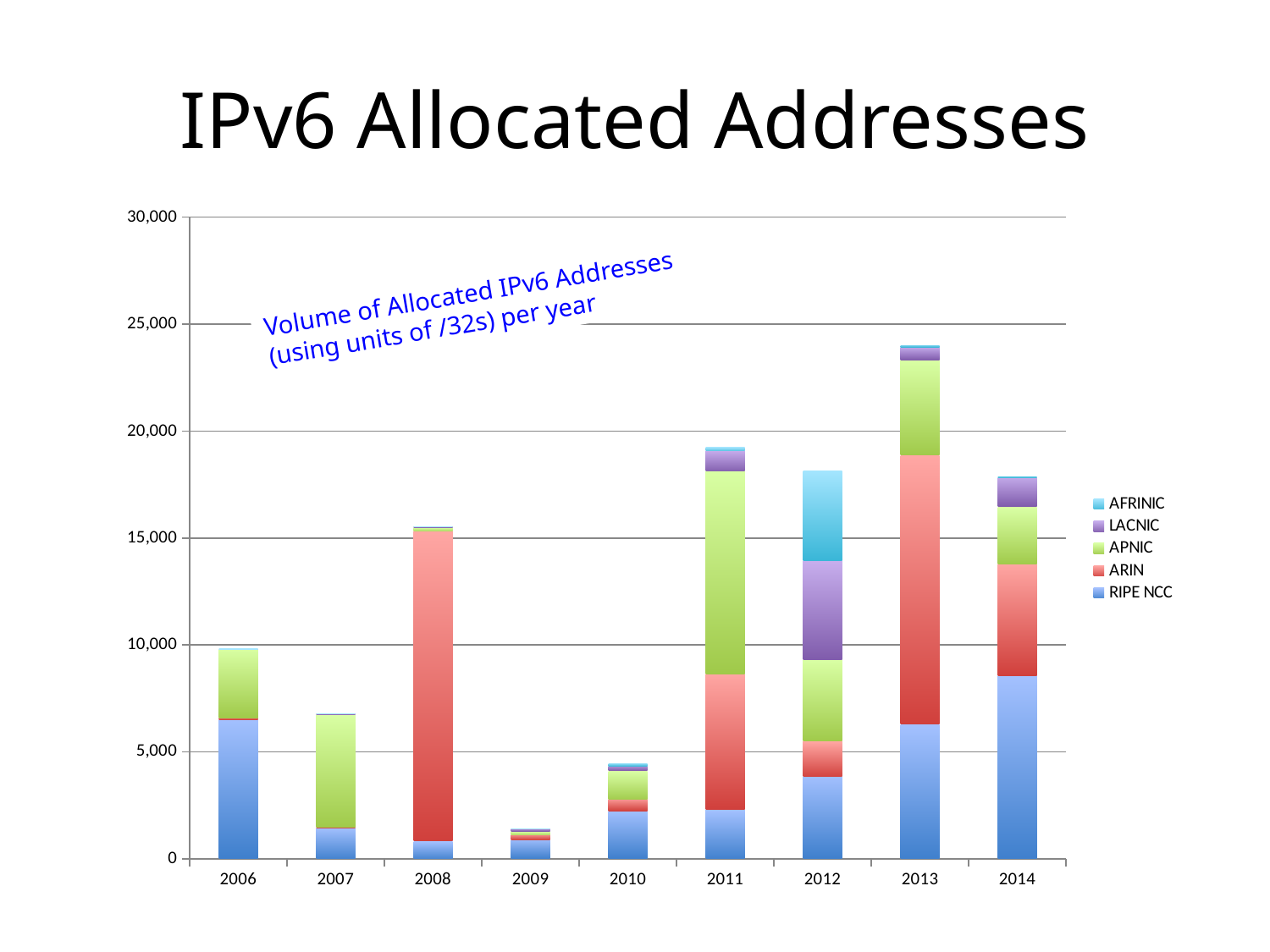
Is the total for 2009 greater or less than 5,000? less Is the total for 2010 greater or less than 5,000? less Which year has the lowest total volume of allocated IPv6 addresses? 2009 Which year has the larger total, 2008 or 2007? 2008 Which series is shown at the bottom of each stacked bar? RIPE NCC Which year has the larger total, 2013 or 2012? 2013 How many series does the chart's legend list? 5 Is the total for 2012 greater or less than 15,000? greater Which year has the highest total volume of allocated IPv6 addresses? 2013 What kind of chart is shown on the slide? Stacked bar chart How many years are shown along the x axis of the chart? 9